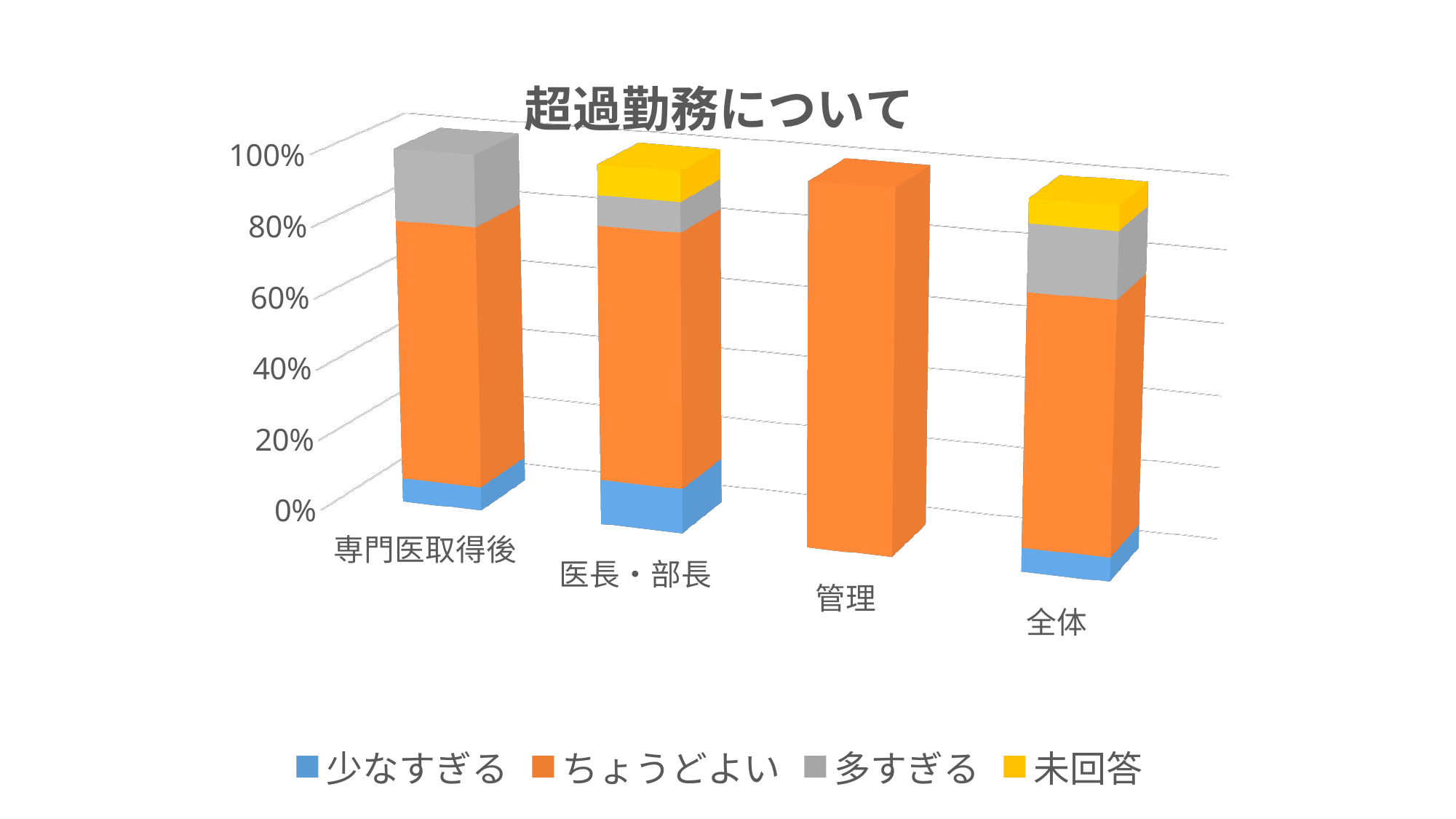
Which category has no 未回答 segment but does have a 多すぎる segment? 専門医取得後 Which has a larger 多すぎる segment, 専門医取得後 or 医長・部長? 専門医取得後 How many categories are shown on the x axis of the chart? 4 What type of chart is shown on the slide? Stacked bar chart Is the ちょうどよい share for 管理 greater or less than 80%? greater Which series is shown in orange in the legend? ちょうどよい Is the 多すぎる share for 医長・部長 greater or less than 20%? less Which category's bar consists entirely of the ちょうどよい series? 管理 Which has a larger 少なすぎる segment, 管理 or 全体? 全体 How many series does the legend list? 4 Which category has the largest 多すぎる segment? 専門医取得後 What is the title of the chart? 超過勤務について